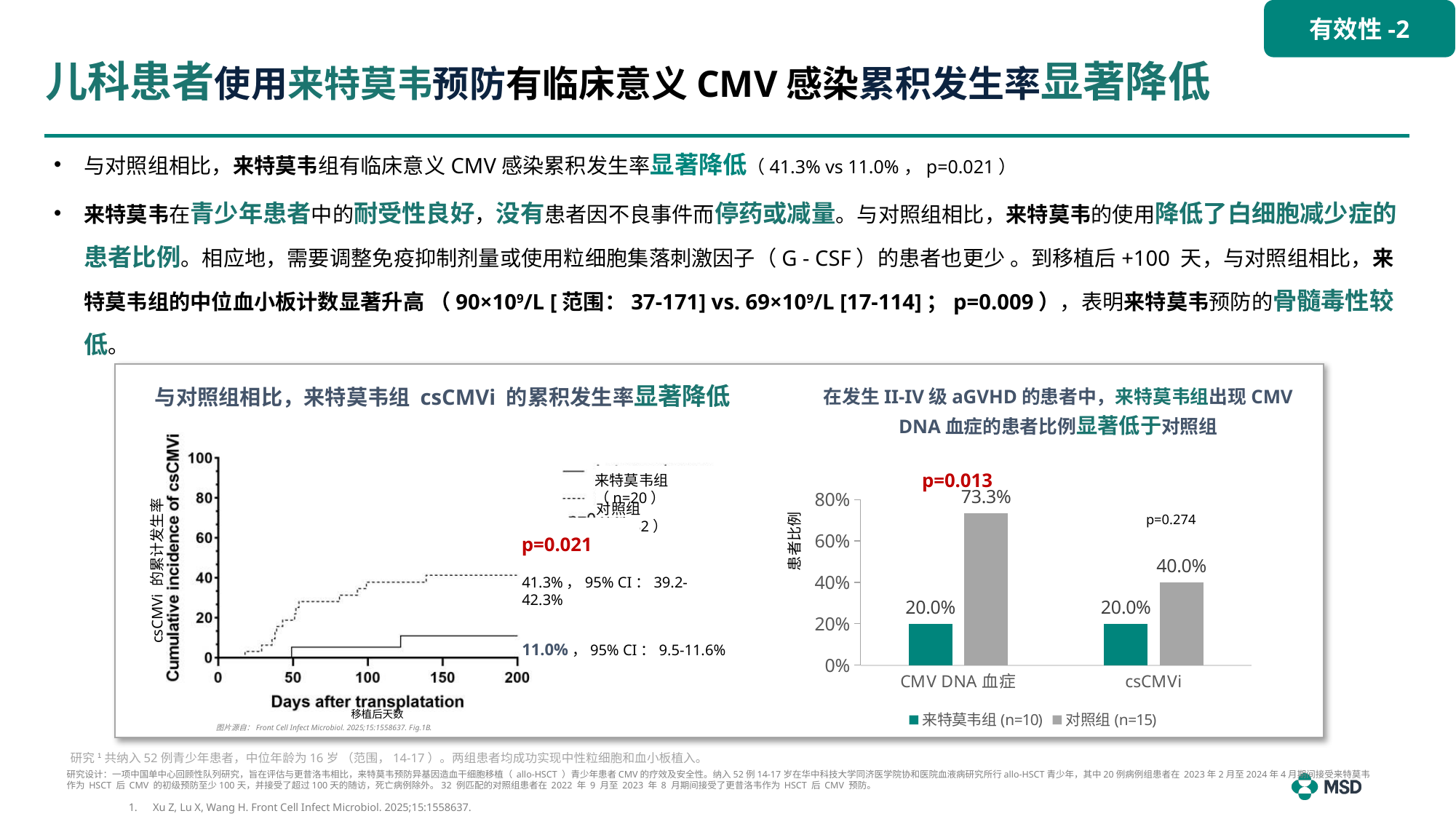
In the right-hand bar chart, what is the value for 来特莫韦组 in the csCMVi category? 20.0% What kind of chart is the right-hand chart on the slide? Bar chart In the right-hand bar chart, what is the difference between 对照组 and 来特莫韦组 in the CMV DNA 血症 category? 53.3% How many categories are shown on the x axis of the right-hand bar chart? 2 In the right-hand bar chart, which is larger for csCMVi: 来特莫韦组 or 对照组? 对照组 In the left-hand cumulative incidence chart, what is the cumulative incidence of csCMVi for 对照组? 41.3% In the right-hand bar chart, what is the difference between 对照组 and 来特莫韦组 in the csCMVi category? 20.0% In the left-hand cumulative incidence chart, what is the cumulative incidence of csCMVi for 来特莫韦组? 11.0% In the right-hand bar chart, what is the value for 对照组 in the csCMVi category? 40.0% In the right-hand bar chart, which bar is the highest? 对照组, CMV DNA 血症 (73.3%) How many series does the legend of the right-hand bar chart list? 2 In the right-hand bar chart, what is the value for 对照组 in the CMV DNA 血症 category? 73.3%